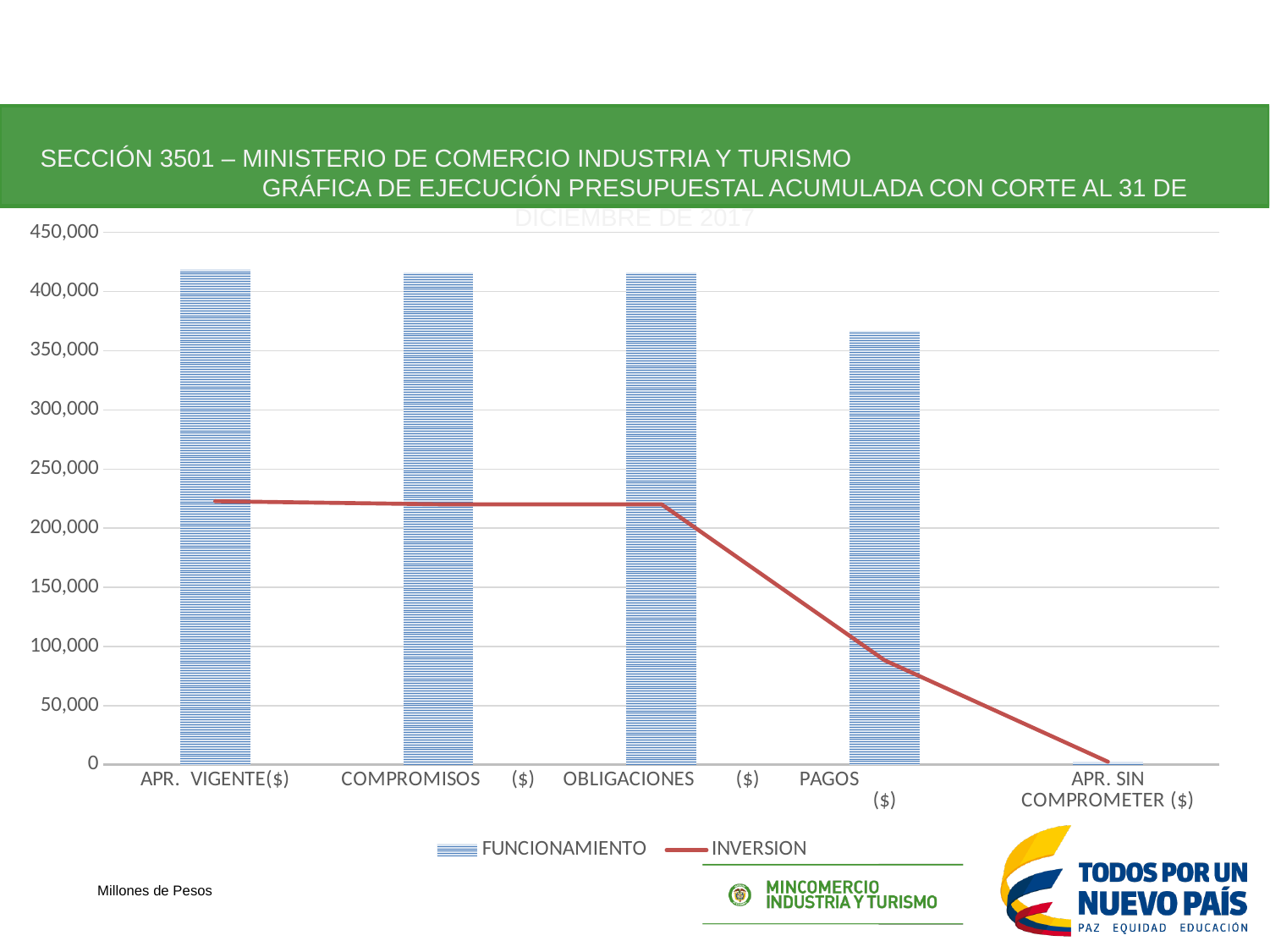
Is the FUNCIONAMIENTO value for APR. VIGENTE($) greater or less than 400,000? greater What are the two series named in the legend? FUNCIONAMIENTO and INVERSION Is the INVERSION value for OBLIGACIONES ($) greater or less than 200,000? greater What kind of chart is this? A combined bar and line chart Which is larger, the FUNCIONAMIENTO value for APR. VIGENTE($) or for PAGOS ($)? APR. VIGENTE($) How many series does the legend list? 2 How many categories are shown on the x axis? 5 Which category has the lowest FUNCIONAMIENTO value? APR. SIN COMPROMETER ($) Does the INVERSION line rise or fall from OBLIGACIONES ($) to APR. SIN COMPROMETER ($)? It falls Is the FUNCIONAMIENTO value for PAGOS ($) greater or less than 400,000? less Which series is drawn as a line? INVERSION